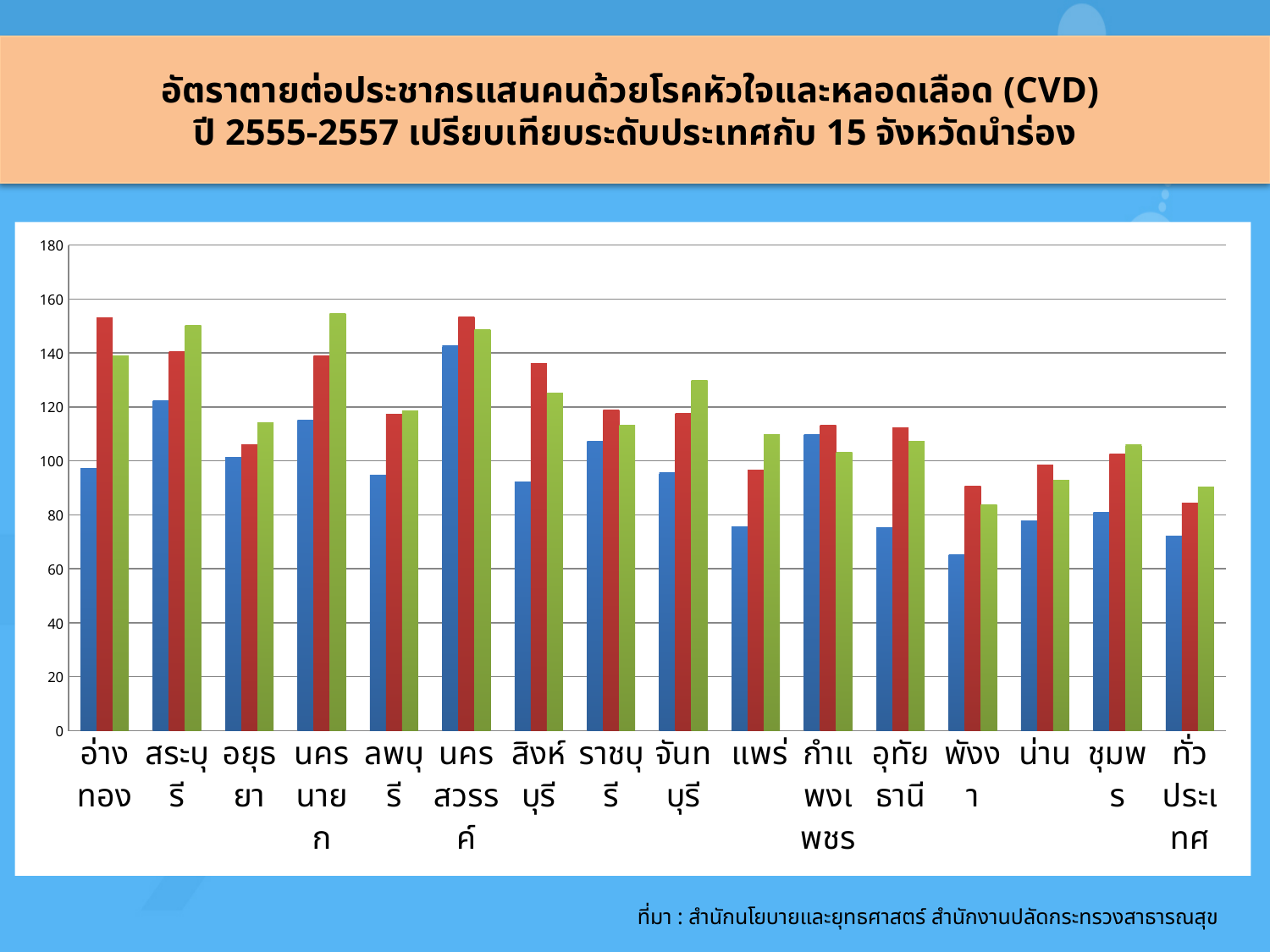
Which category has the tallest blue bar? นครสวรรค์ Which is larger, the blue bar for สระบุรี or the blue bar for อยุธยา? สระบุรี Which category has the shortest blue bar? พังงา Is the green bar for จันทบุรี greater or less than 120? greater Is the blue bar for พังงา greater or less than 80? less How many categories are shown along the x axis of the chart? 16 Which is larger, the green bar for อ่างทอง or the green bar for อยุธยา? อ่างทอง What kind of chart is shown on the slide? bar chart Which category has the shortest green bar? พังงา Is the blue bar for นครสวรรค์ greater or less than 140? greater How many bars are plotted for each category in the chart? 3